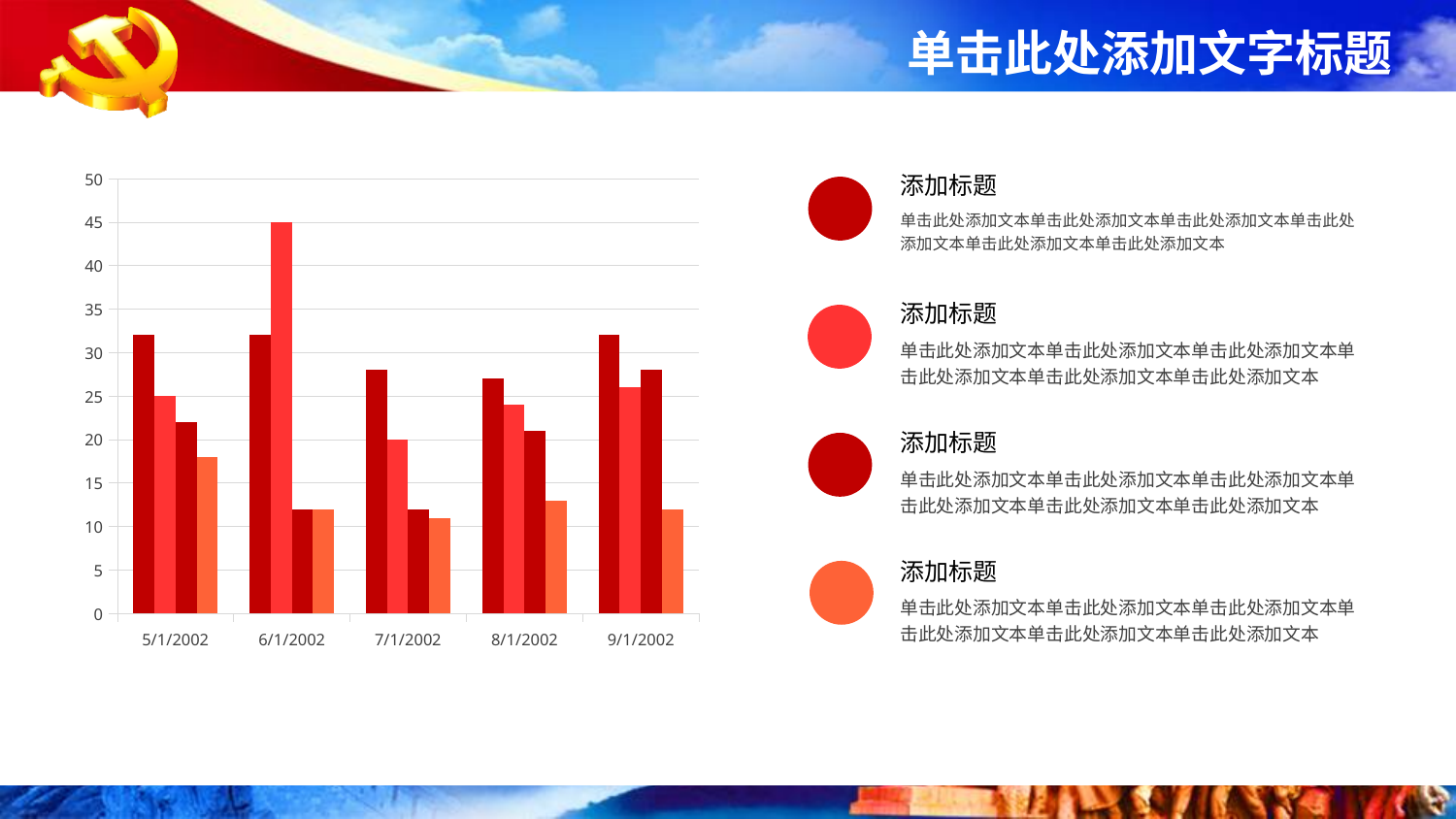
What kind of chart is shown on the slide? bar chart How many bars are plotted for each date category? 4 Is the first (dark red) bar for 7/1/2002 greater or less than 25? greater What is the highest value shown on the y axis of the chart? 50 Which is taller: the first (dark red) bar for 5/1/2002 or the first (dark red) bar for 7/1/2002? 5/1/2002 Is the tallest bar for 6/1/2002 greater or less than 40? greater What value does the tallest bar (the bright red bar for 6/1/2002) reach on the y axis? 45 Is the last (orange) bar for 5/1/2002 greater or less than 20? less Which date category contains the tallest bar in the chart? 6/1/2002 How many date categories are shown on the x axis of the chart? 5